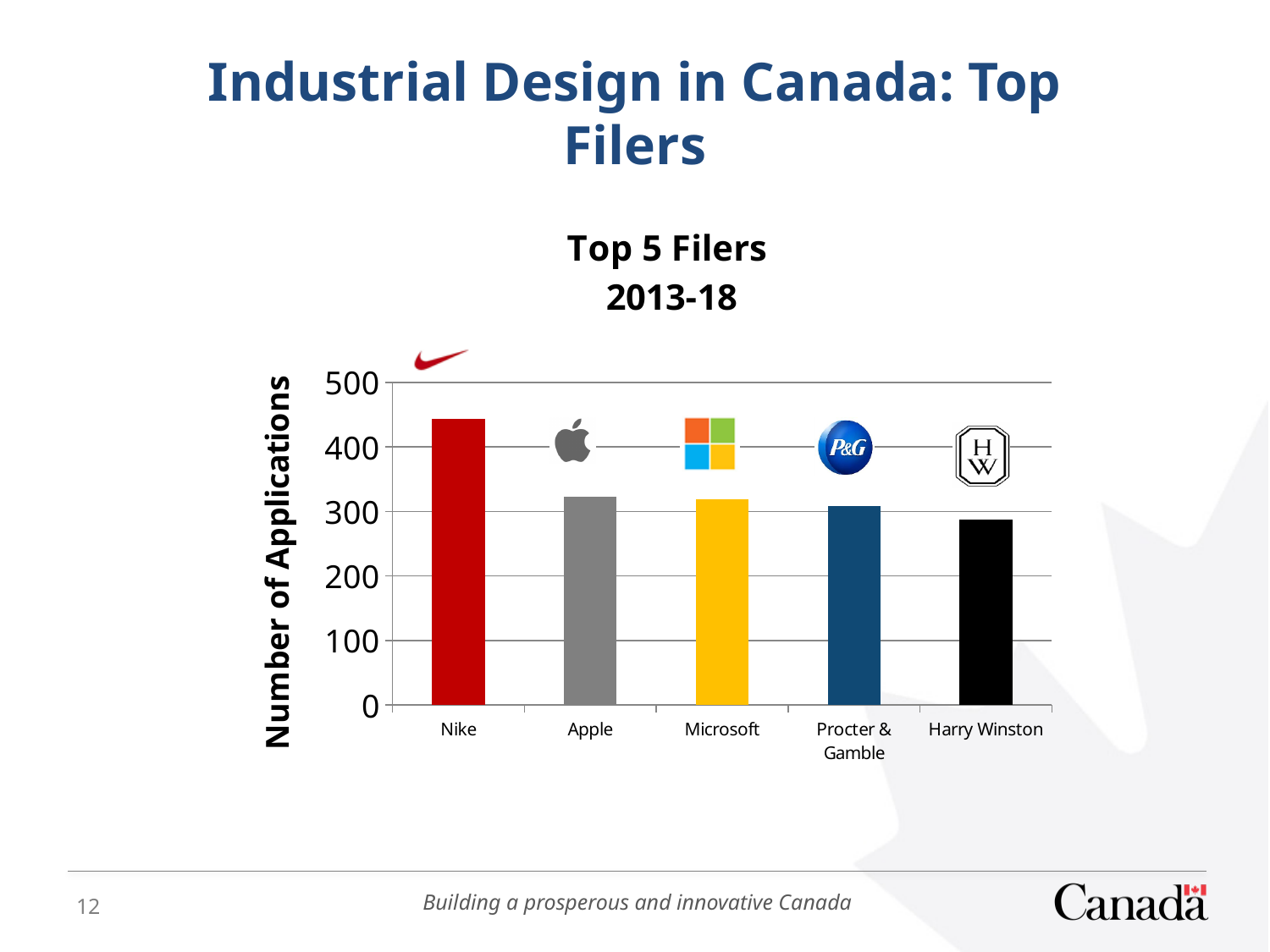
Is the value for Harry Winston greater or less than 300? less Which has more applications, Nike or Apple? Nike What kind of chart is shown on the slide? bar chart Is the value for Apple greater or less than 300? greater What is the label on the vertical axis of the chart? Number of Applications Is the value for Nike greater or less than 500? less Which has more applications, Apple or Harry Winston? Apple Which filer has the lowest number of applications? Harry Winston How many filers are shown in the chart? 5 Which filer has the highest number of applications? Nike Do the values rise or fall from left to right across the filers? fall